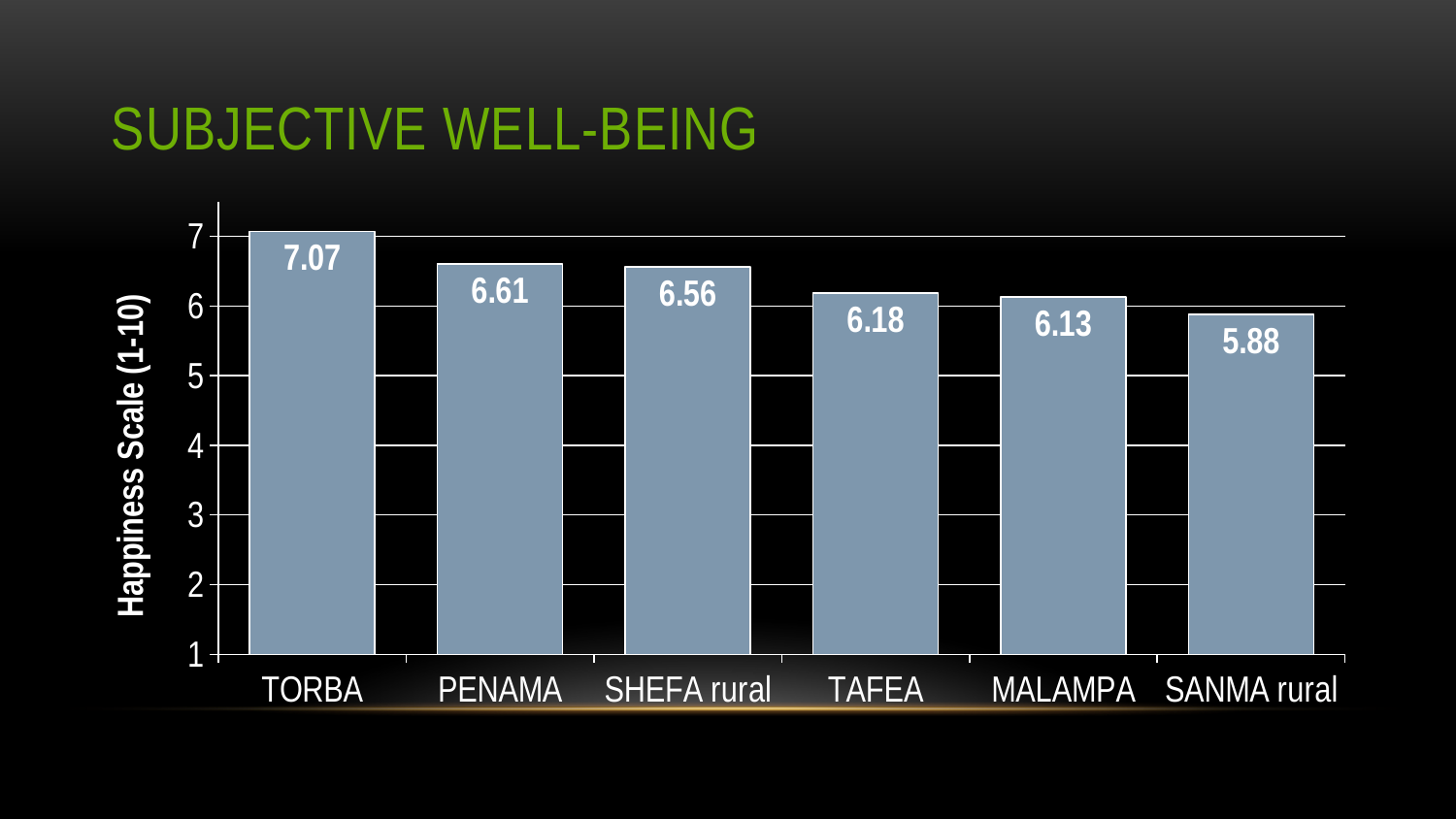
What is the difference between the happiness scale values for PENAMA and TAFEA? 0.43 Do the values rise or fall from left to right along the x axis? Fall What is the difference between the happiness scale values for TORBA and SANMA rural? 1.19 Which province has the highest happiness scale value? TORBA What is the happiness scale value for SHEFA rural? 6.56 How many provinces are shown on the chart? 6 Is the value for TAFEA greater or less than 6? greater What is the happiness scale value for TORBA? 7.07 Which province has the lowest happiness scale value? SANMA rural What kind of chart is shown on the slide? Bar chart Which has a higher happiness scale value, PENAMA or MALAMPA? PENAMA What is the happiness scale value for SANMA rural? 5.88